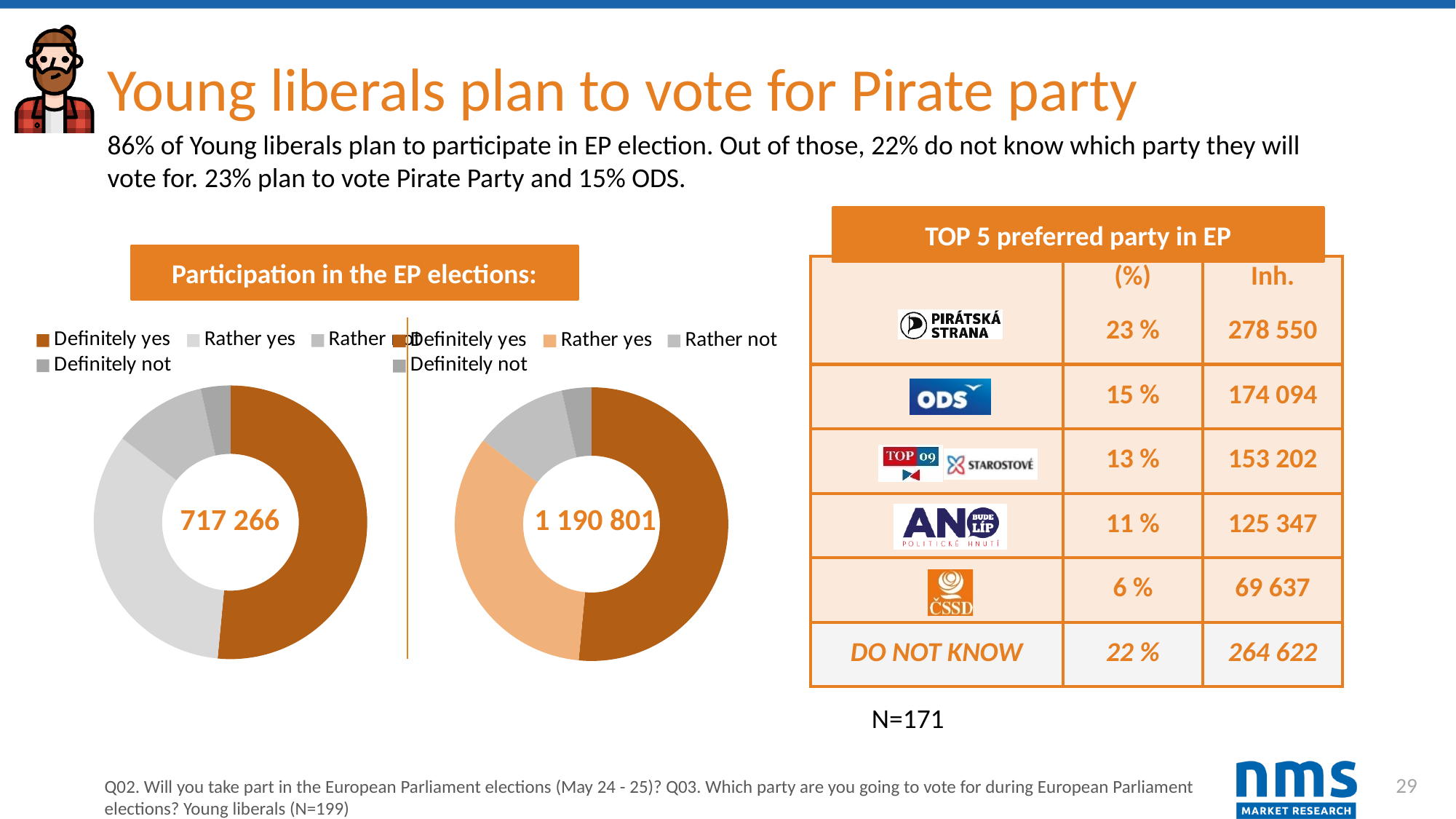
In the right pie chart, which category has the largest slice? Definitely yes In the left pie chart, which category has the smallest slice? Definitely not What number is printed in the centre of the right pie chart? 1 190 801 In the left pie chart, which slice is larger: 'Rather yes' or 'Rather not'? Rather yes What number is printed in the centre of the left pie chart? 717 266 In the right pie chart, which slice is larger: 'Rather yes' or 'Rather not'? Rather yes How many entries does the legend of the left pie chart list? 4 In the left pie chart, which category has the largest slice? Definitely yes What kind of chart is the left chart under 'Participation in the EP elections:'? doughnut chart In the right pie chart, which category has the smallest slice? Definitely not What is the heading shown above the two pie charts? Participation in the EP elections: How many pie charts are shown on the slide? 2